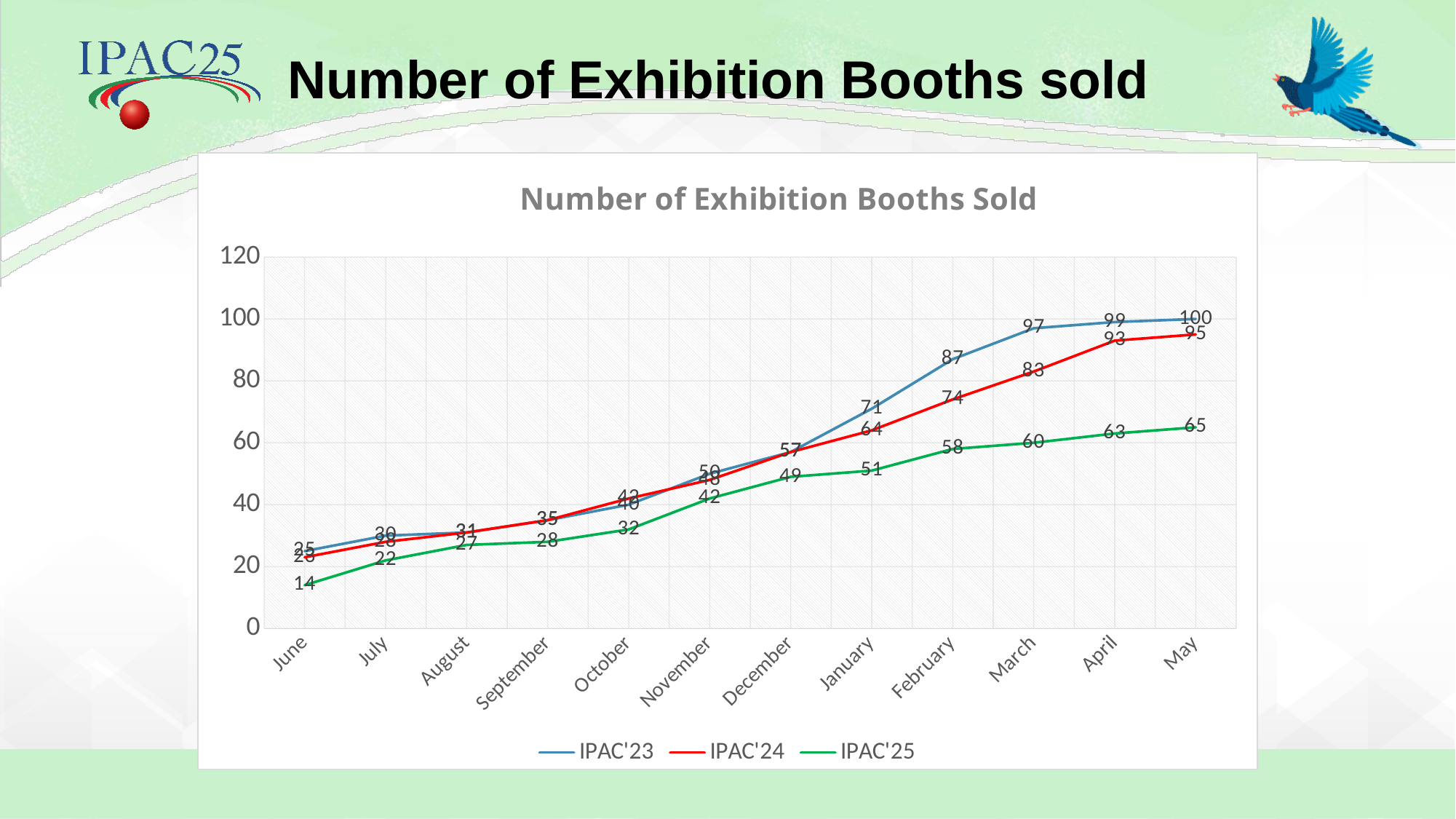
How many months are shown along the x axis? 12 What is the value for IPAC'25 in June? 14 How many series does the legend list? 3 Do the IPAC'25 values rise or fall from June to May? rise What is the value for IPAC'25 in December? 49 Which series has the highest value in May? IPAC'23 What is the value for IPAC'23 in May? 100 Which series is drawn in green? IPAC'25 What is the value for IPAC'24 in March? 83 In February, which is larger: IPAC'24 or IPAC'25? IPAC'24 What kind of chart is shown on the slide? line chart What is the difference between IPAC'23 and IPAC'25 in May? 35